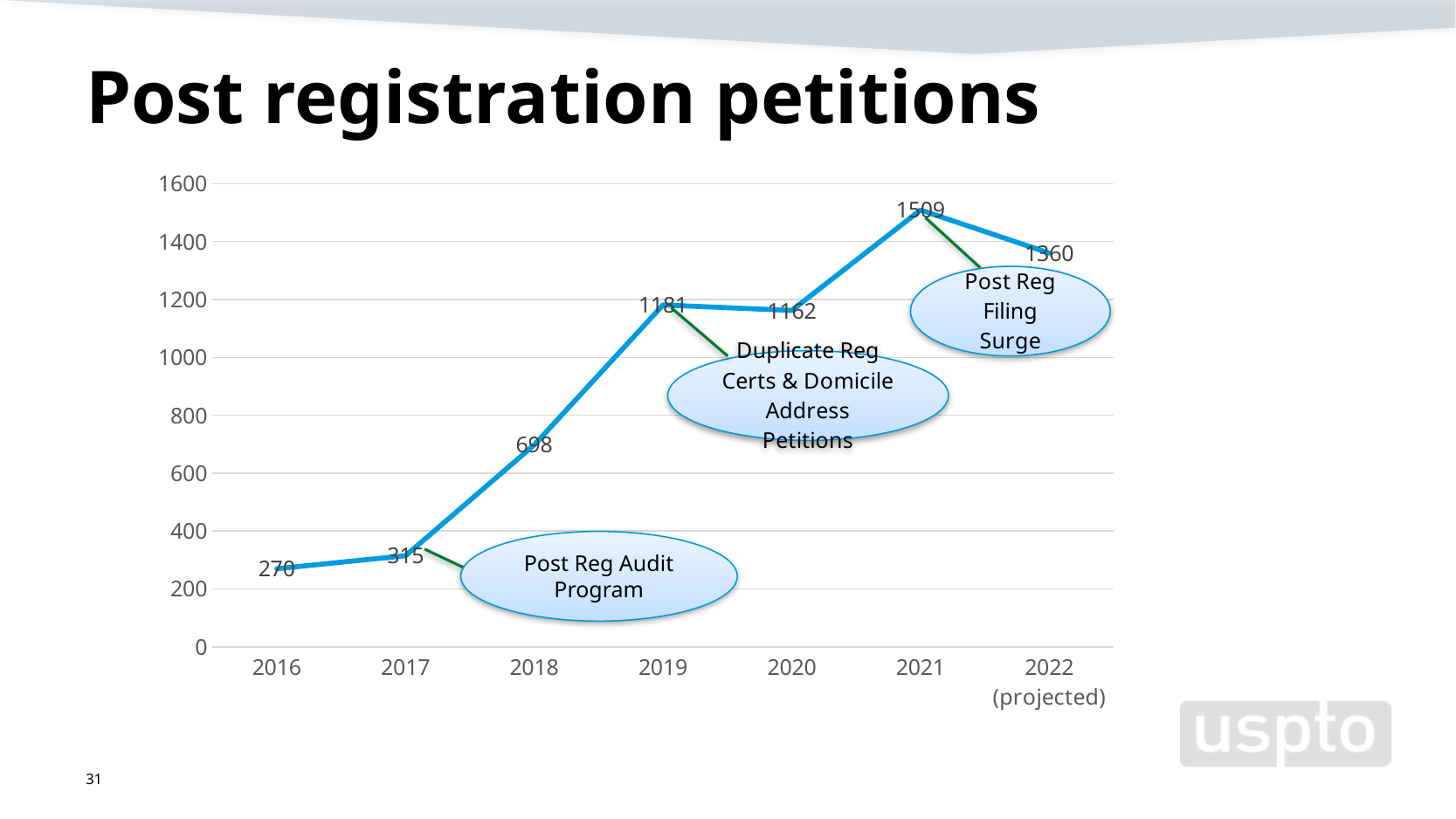
Which year has the lowest value? 2016 What is the value for 2021? 1509 How many years are plotted on the x axis? 7 What is the difference between the values for 2021 and 2022 (projected)? 149 What kind of chart is shown on the slide? Line chart What is the value for 2016? 270 Which is larger, the value for 2019 or the value for 2020? 2019 What is the difference between the values for 2018 and 2017? 383 What is the title of the slide's chart? Post registration petitions What is the projected value for 2022? 1360 What is the value for 2018? 698 Which year has the highest value? 2021